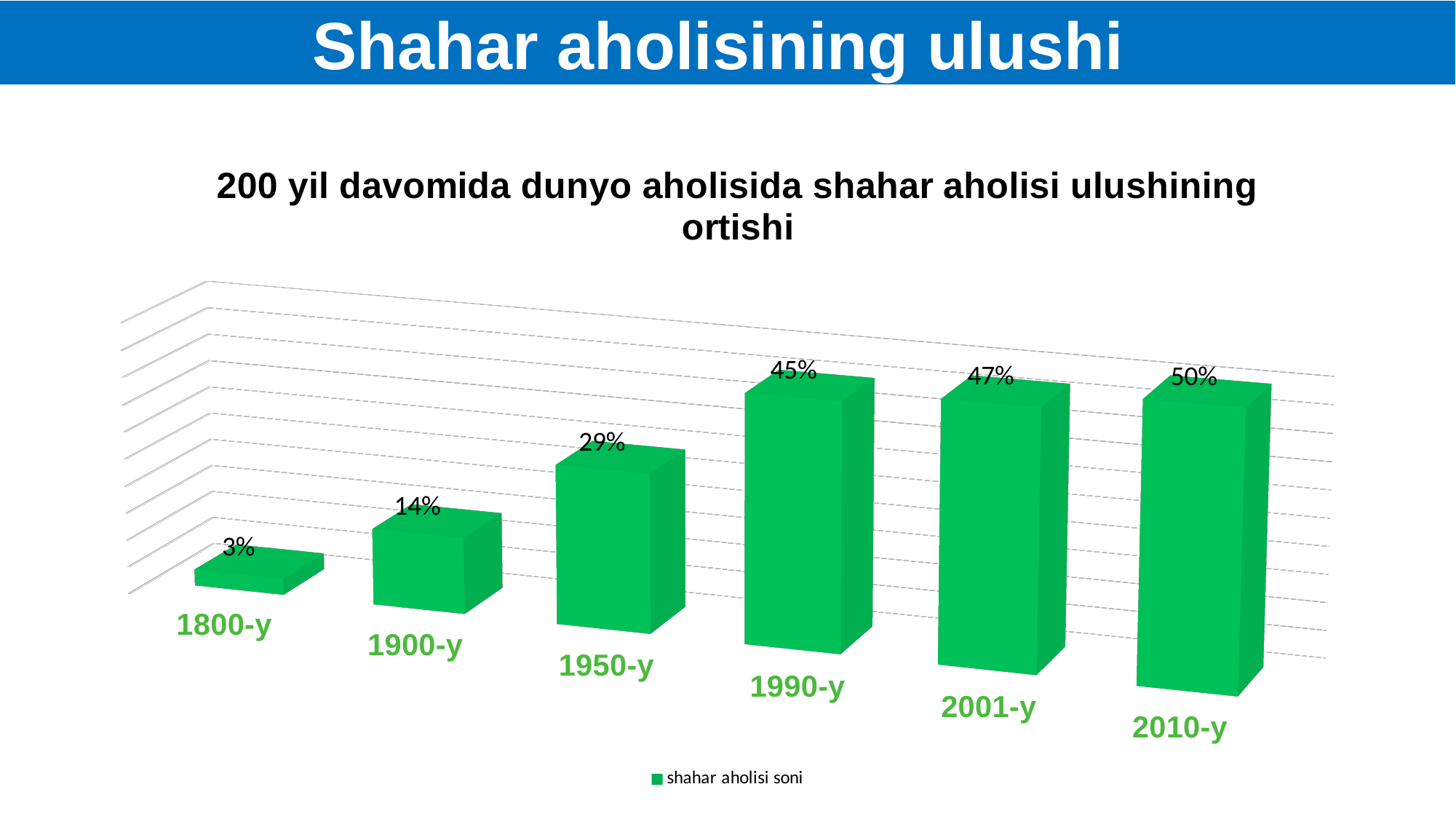
How many categories are shown on the x axis? 6 What kind of chart is shown? bar chart What is the value for 1800-y? 3% How many series does the legend list? 1 What is the value for 2001-y? 47% What is the difference between the values for 1950-y and 1900-y? 15% Which category has the highest value? 2010-y What is the difference between the values for 2010-y and 1990-y? 5% Which category has the lowest value? 1800-y What is the value for 1950-y? 29% Do the values rise or fall from 1800-y to 2010-y? rise Which is larger, the value for 1900-y or the value for 1950-y? 1950-y